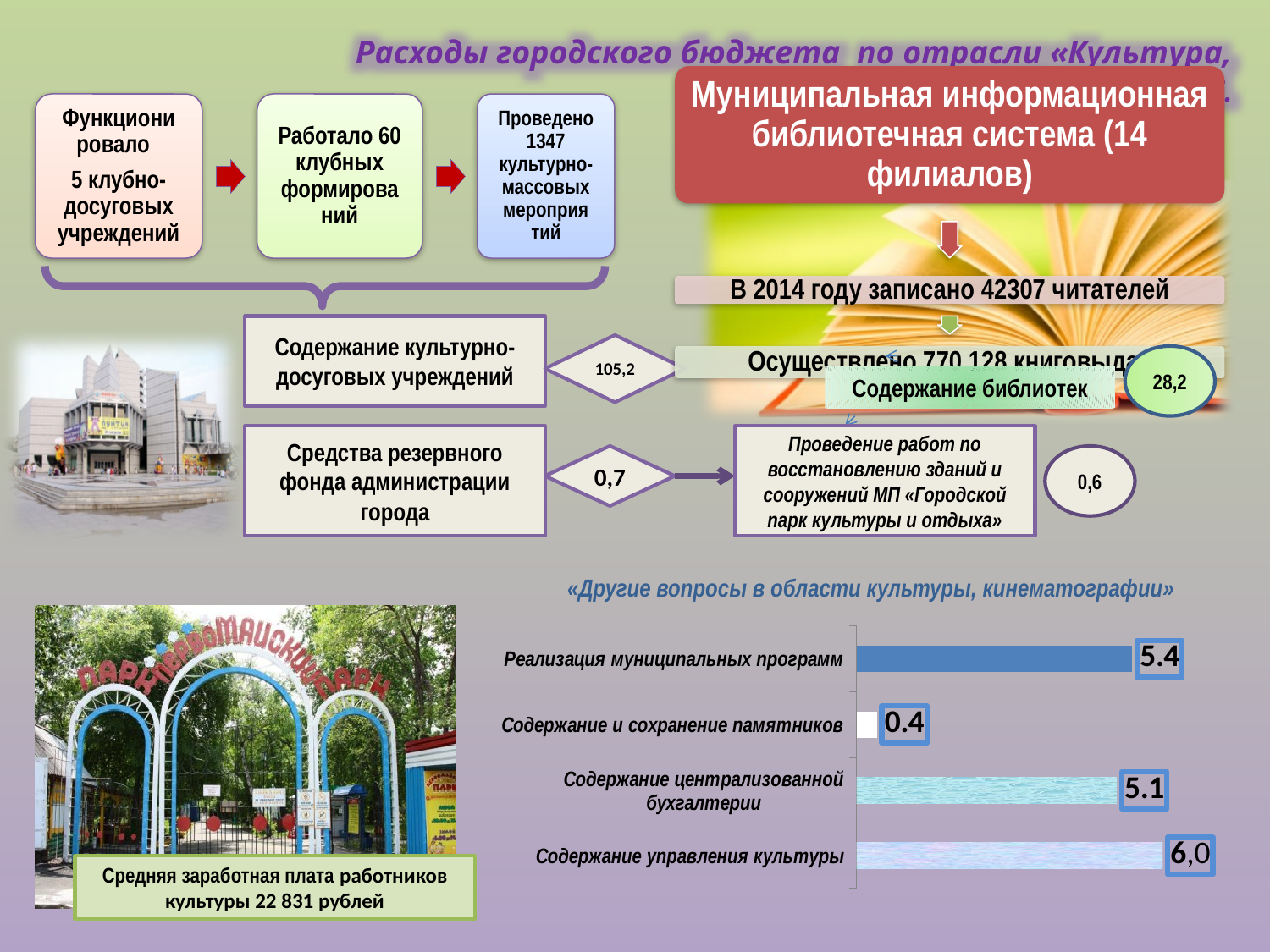
What type of chart is shown under the heading «Другие вопросы в области культуры, кинематографии»? bar chart In the bar chart «Другие вопросы в области культуры, кинематографии», what is the difference between the values for Содержание управления культуры and Содержание централизованной бухгалтерии? 0.9 In the bar chart «Другие вопросы в области культуры, кинематографии», are the bars oriented horizontally or vertically? horizontally In the bar chart «Другие вопросы в области культуры, кинематографии», which is larger: Реализация муниципальных программ or Содержание централизованной бухгалтерии? Реализация муниципальных программ In the bar chart «Другие вопросы в области культуры, кинематографии», what is the value for Реализация муниципальных программ? 5.4 In the bar chart «Другие вопросы в области культуры, кинематографии», what is the value for Содержание и сохранение памятников? 0.4 In the bar chart «Другие вопросы в области культуры, кинематографии», what is the value for Содержание управления культуры? 6,0 In the bar chart «Другие вопросы в области культуры, кинематографии», how many categories are plotted? 4 In the bar chart «Другие вопросы в области культуры, кинематографии», which category has the highest value? Содержание управления культуры In the bar chart «Другие вопросы в области культуры, кинематографии», what is the difference between the values for Реализация муниципальных программ and Содержание и сохранение памятников? 5.0 In the bar chart «Другие вопросы в области культуры, кинематографии», what is the value for Содержание централизованной бухгалтерии? 5.1 In the bar chart «Другие вопросы в области культуры, кинематографии», which category has the lowest value? Содержание и сохранение памятников